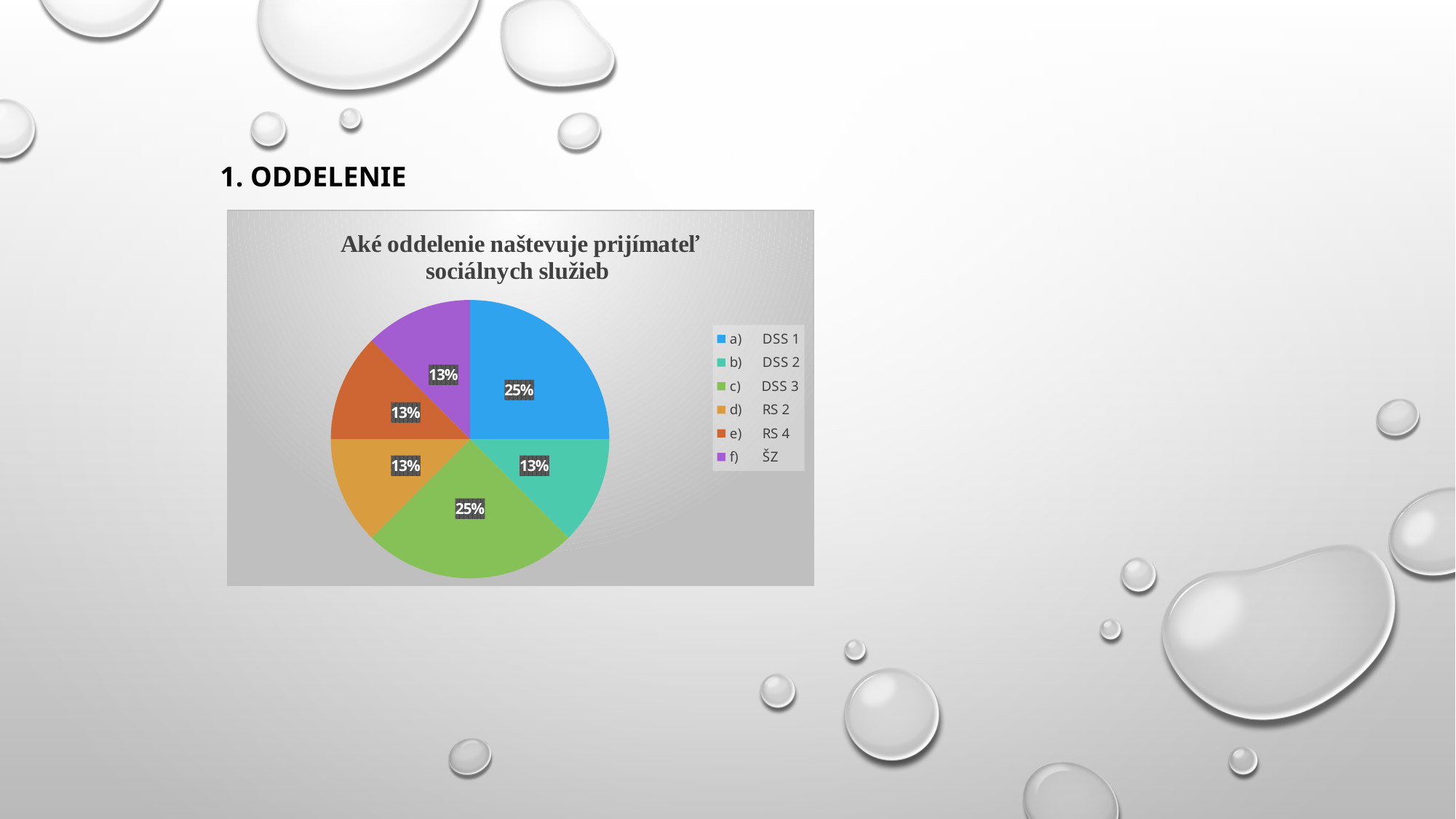
What is the difference in percentage points between the slice for c) DSS 3 and the slice for d) RS 2? 12 What type of chart is shown on the slide? pie chart What is the value shown for f) ŠZ? 13% Which is larger, the slice for a) DSS 1 or the slice for e) RS 4? a) DSS 1 How many slices does the pie chart have? 6 What is the value shown for d) RS 2? 13% What colour is the slice for f) ŠZ? purple What share of the pie does a) DSS 1 represent? 25% What is the title of the chart? Aké oddelenie naštevuje prijímateľ sociálnych služieb What is the value shown for b) DSS 2? 13% What share of the pie does c) DSS 3 represent? 25% How many entries does the legend list? 6